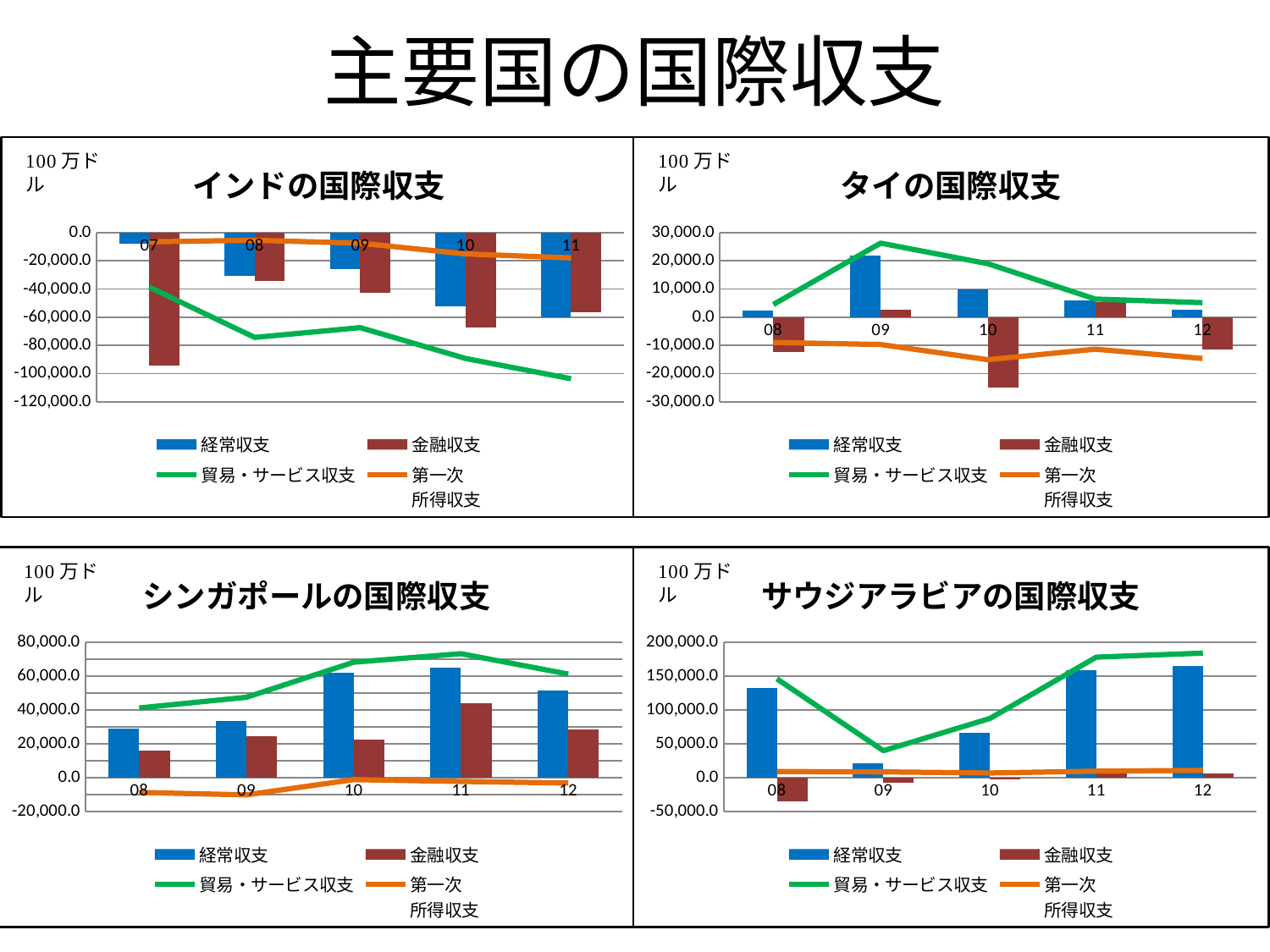
In the タイの国際収支 chart, which year has the lowest 金融収支? 10 In the インドの国際収支 chart, does the 貿易・サービス収支 line rise or fall from 07 to 11? fall How many charts are shown on the slide? 4 In the シンガポールの国際収支 chart, which year has the highest 経常収支? 11 In the インドの国際収支 chart, is the 金融収支 value for 07 greater or less than -80,000.0? less In the インドの国際収支 chart, how many series does the legend list? 4 What kind of chart is the サウジアラビアの国際収支 chart? combined bar and line chart In the タイの国際収支 chart, is the 金融収支 value for 10 greater or less than -20,000.0? less In the インドの国際収支 chart, how many years are shown on the x axis? 5 In the サウジアラビアの国際収支 chart, which is larger, the 経常収支 for 09 or for 12? 12 In the シンガポールの国際収支 chart, is the 経常収支 value for 11 greater or less than 60,000.0? greater In the タイの国際収支 chart, which year has the highest 経常収支? 09